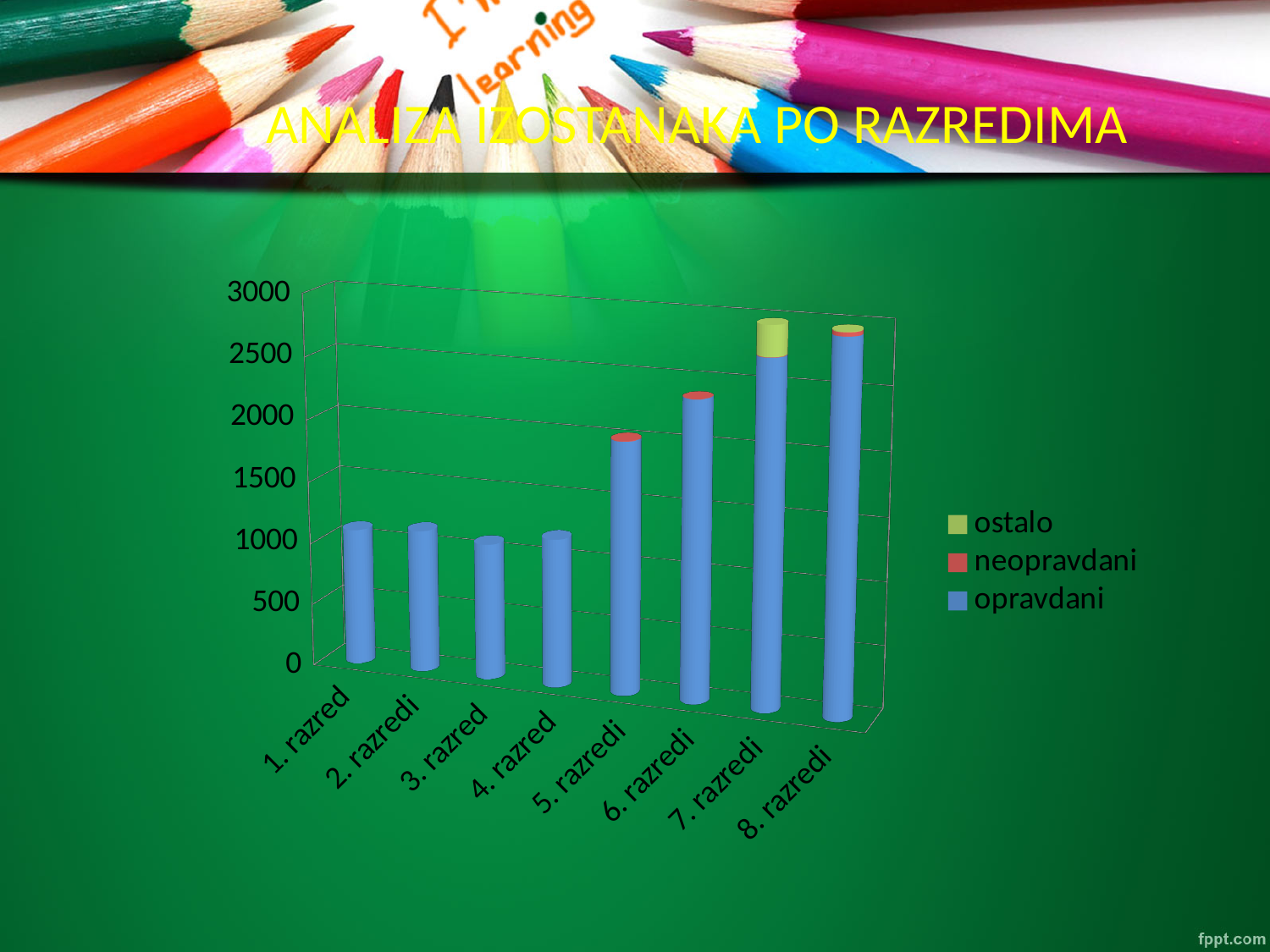
Which has a larger total, 5. razredi or 1. razred? 5. razredi Which has a larger total, 6. razredi or 5. razredi? 6. razredi Is the total value for 3. razred greater or less than 1500? less Is the total value for 8. razredi greater or less than 3000? less What is the title of the chart on the slide? ANALIZA IZOSTANAKA PO RAZREDIMA What type of chart is shown on the slide? bar chart Which series in the chart is shown in blue? opravdani Is the total value for 7. razredi greater or less than 2000? greater How many categories (classes) are shown on the x axis of the chart? 8 How many series does the chart's legend list? 3